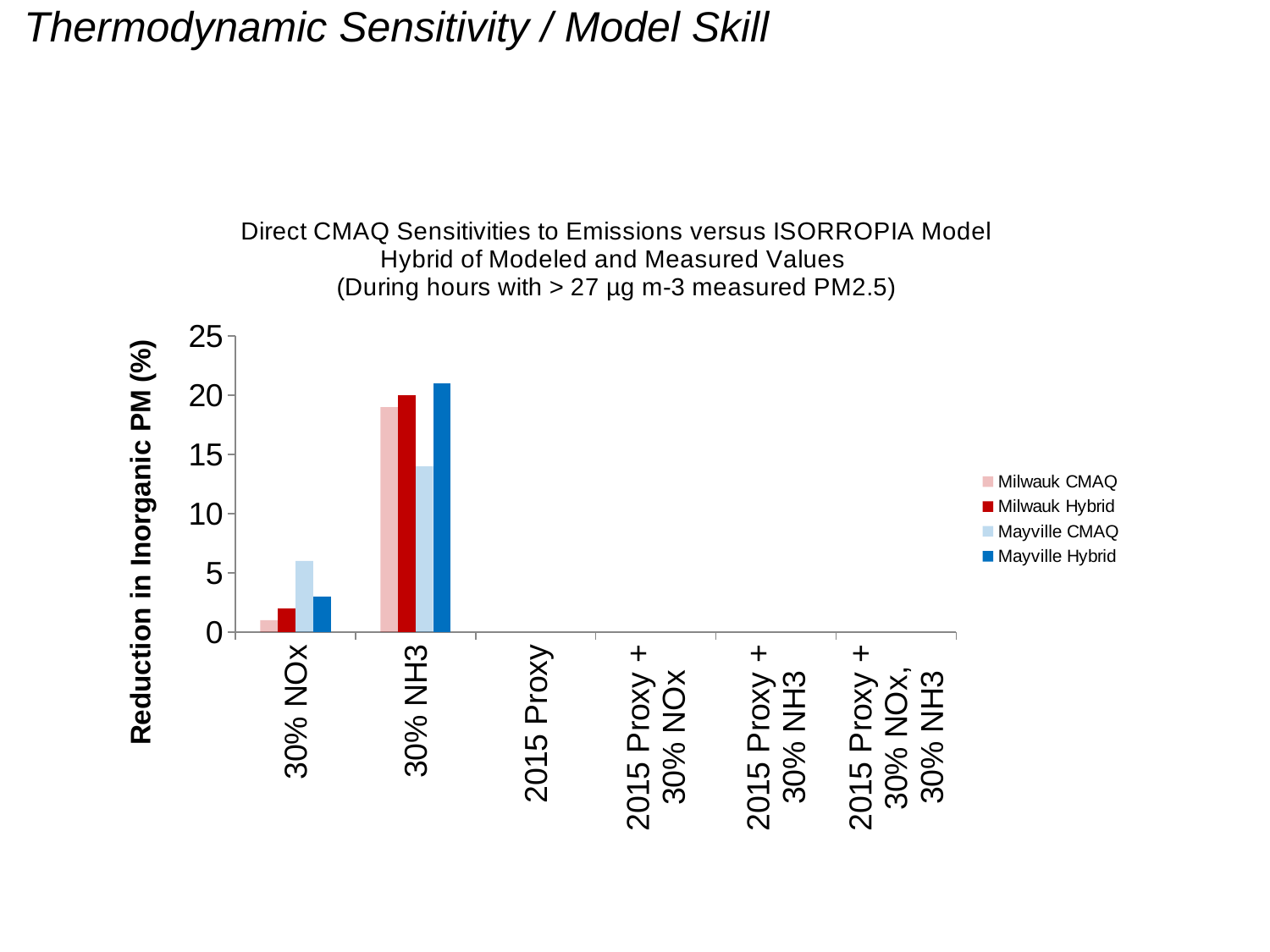
Is the Mayville CMAQ value for 30% NH3 greater or less than 15? less What is the title of the y axis? Reduction in Inorganic PM (%) What kind of chart is shown on the slide? bar chart Is the Mayville CMAQ value for 30% NOx greater or less than 5? greater For the Milwauk CMAQ series, which category has the larger value: 30% NOx or 30% NH3? 30% NH3 How many categories are shown on the x axis? 6 Is the Milwauk CMAQ value for 30% NH3 greater or less than 15? greater Which series has the lowest value for the 30% NH3 category? Mayville CMAQ Which series has the highest value for the 30% NOx category? Mayville CMAQ How many series does the legend list? 4 Which series has the lowest value for the 30% NOx category? Milwauk CMAQ